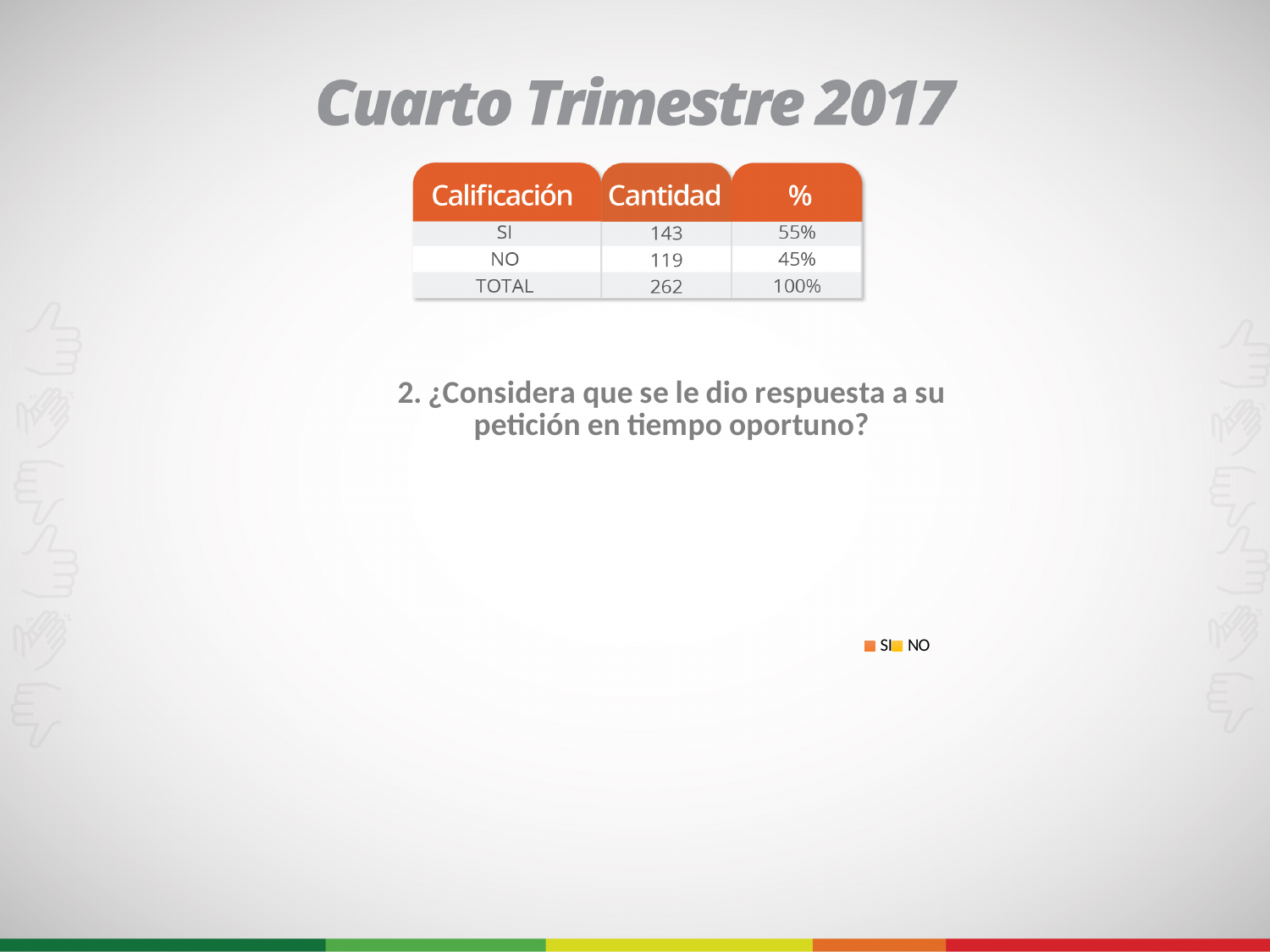
How many entries does the chart legend list? 2 According to the table on the slide, what is the Cantidad for SI? 143 According to the table on the slide, what is the difference in Cantidad between SI and NO? 24 According to the table on the slide, what is the Cantidad for NO? 119 According to the table on the slide, what percentage corresponds to NO? 45% According to the table on the slide, what is the TOTAL Cantidad? 262 According to the table on the slide, which response has the higher Cantidad, SI or NO? SI What are the entries shown in the chart legend? SI, NO According to the table on the slide, what percentage corresponds to SI? 55%